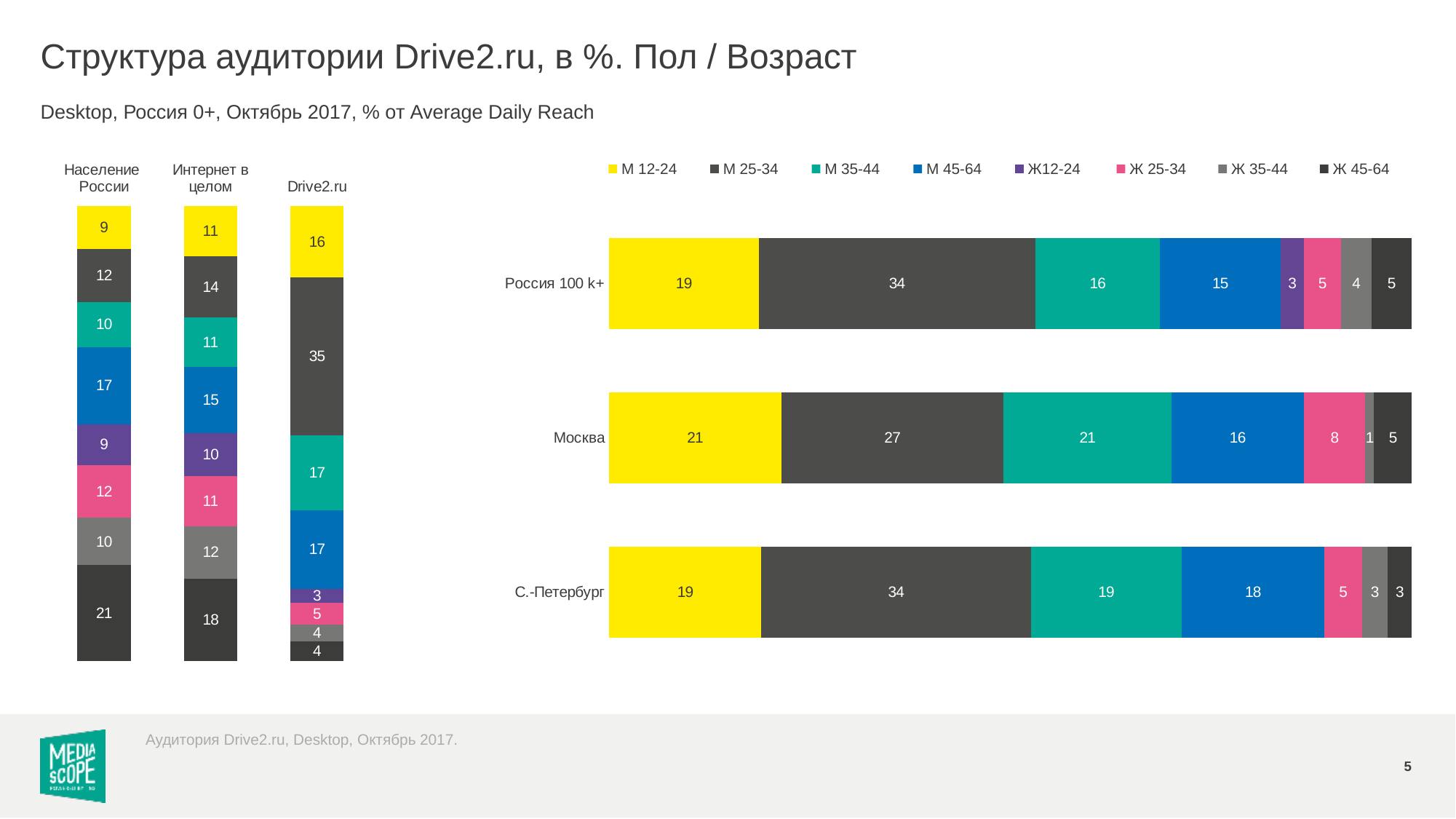
In the right-hand chart, what is the difference between the М 25-34 values for Россия 100 k+ and Москва? 7 In the right-hand chart, what is the value for М 12-24 in the Москва bar? 21 In the left-hand chart, what is the value of the М 25-34 (dark grey) segment in the Drive2.ru column? 35 What kind of chart is the right-hand chart? Stacked bar chart How many series does the legend of the right-hand chart list? 8 In the right-hand chart, which colour represents the М 12-24 series? Yellow In the right-hand chart, what is the value for Ж 25-34 in the Москва bar? 8 In the left-hand chart, what is the value of the bottom (Ж 45-64) segment in the Население России column? 21 In the right-hand chart, what is the value for М 25-34 in the Россия 100 k+ bar? 34 How many categories (bars) are shown in the right-hand chart? 3 In the left-hand chart, which column has the larger М 12-24 (yellow) value: Интернет в целом or Drive2.ru? Drive2.ru In the right-hand chart, which segment is the largest in the С.-Петербург bar? М 25-34